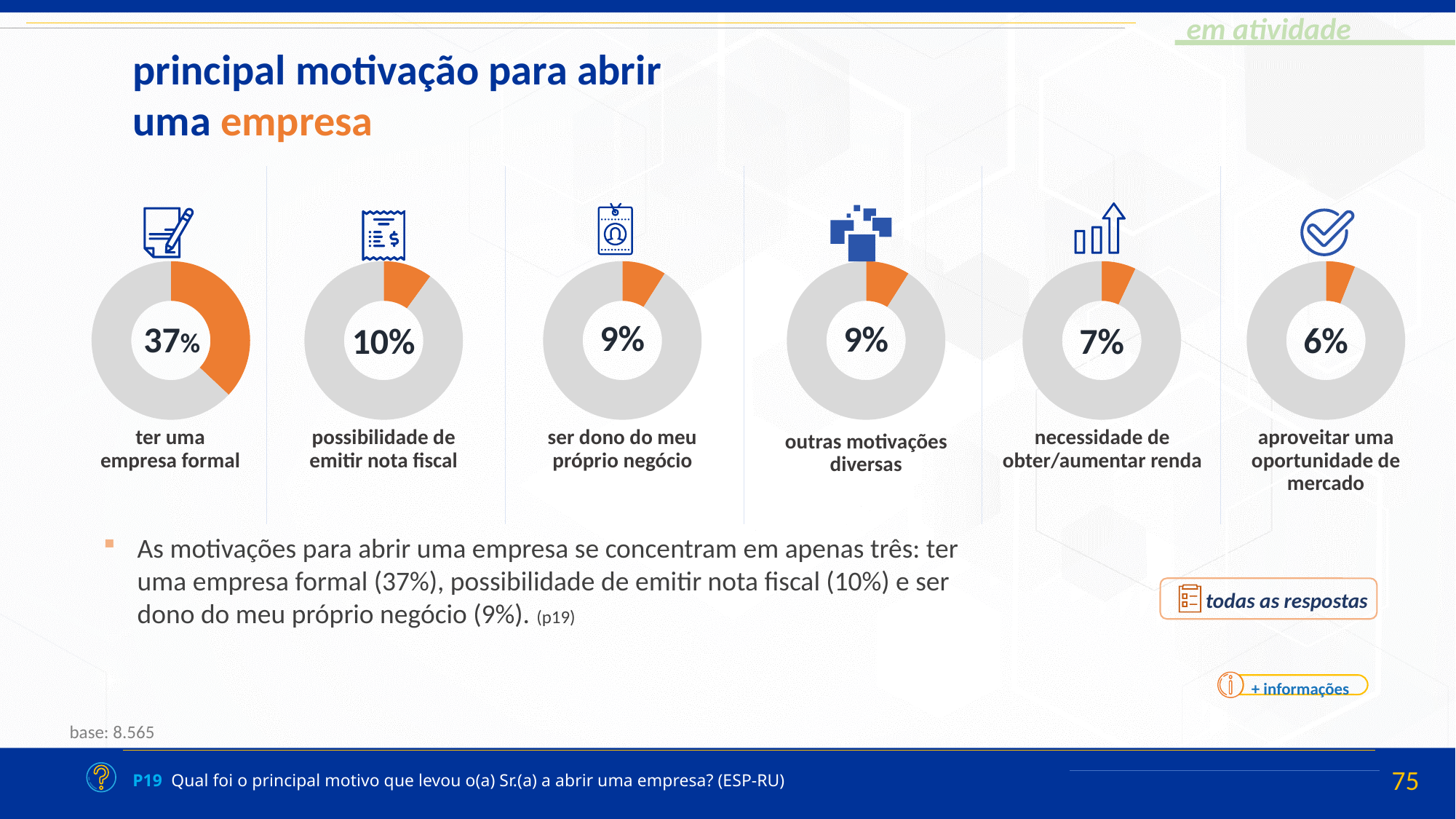
How many donut charts are shown on the slide? 6 Which is larger: the value for "possibilidade de emitir nota fiscal" or the value for "necessidade de obter/aumentar renda"? possibilidade de emitir nota fiscal What percentage is shown for "necessidade de obter/aumentar renda"? 7% Which motivation has the highest percentage among the donut charts? ter uma empresa formal What colour is the highlighted slice in each donut chart? Orange What percentage is shown for "outras motivações diversas"? 9% What kind of chart is used to show each motivation's percentage? Donut (pie) chart What value does the donut chart for "possibilidade de emitir nota fiscal" show? 10% What is the difference in percentage points between "ter uma empresa formal" and "possibilidade de emitir nota fiscal"? 27 percentage points What value is shown in the donut chart for "aproveitar uma oportunidade de mercado"? 6% Which motivation has the lowest percentage among the donut charts? aproveitar uma oportunidade de mercado What percentage is shown in the donut chart labelled "ter uma empresa formal"? 37%